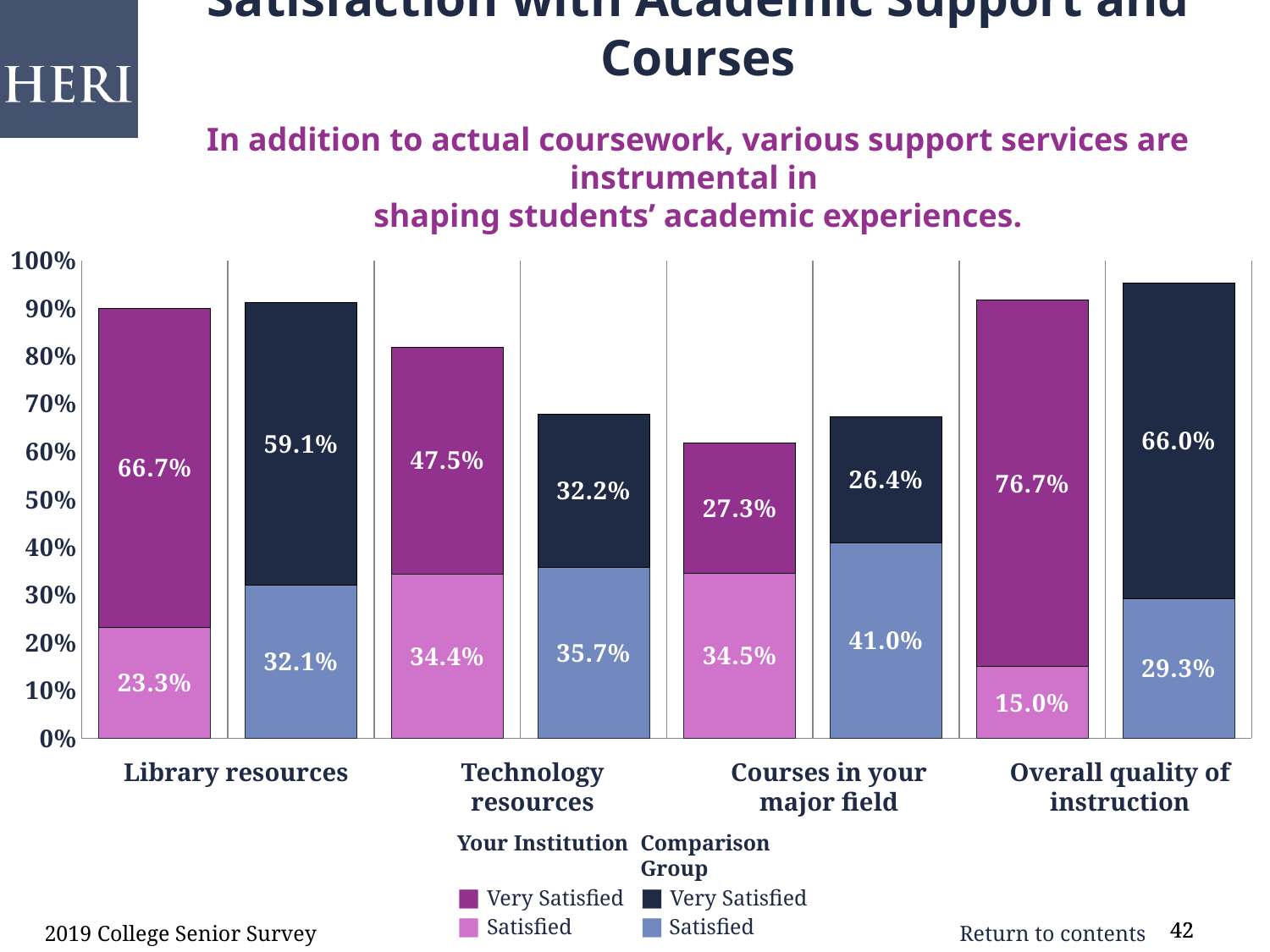
What percentage of Your Institution students were Very Satisfied with Library resources? 66.7% What percentage of the Comparison Group was Satisfied with Courses in your major field? 41.0% What kind of chart is shown on the slide? Stacked bar chart How many series does the legend list? 4 How many categories are shown on the x axis? 4 For Library resources, which is larger: the Satisfied percentage for Your Institution or for the Comparison Group? Comparison Group What is the total of the stacked bar for Your Institution for Overall quality of instruction? 91.7% What is the total of the stacked bar for the Comparison Group for Technology resources? 67.9% What percentage of Your Institution students were Satisfied with Overall quality of instruction? 15.0% Which category has the lowest Very Satisfied percentage for the Comparison Group? Courses in your major field What is the difference between the Very Satisfied percentages for Your Institution and the Comparison Group for Technology resources? 15.3% Which category has the highest Very Satisfied percentage for Your Institution? Overall quality of instruction